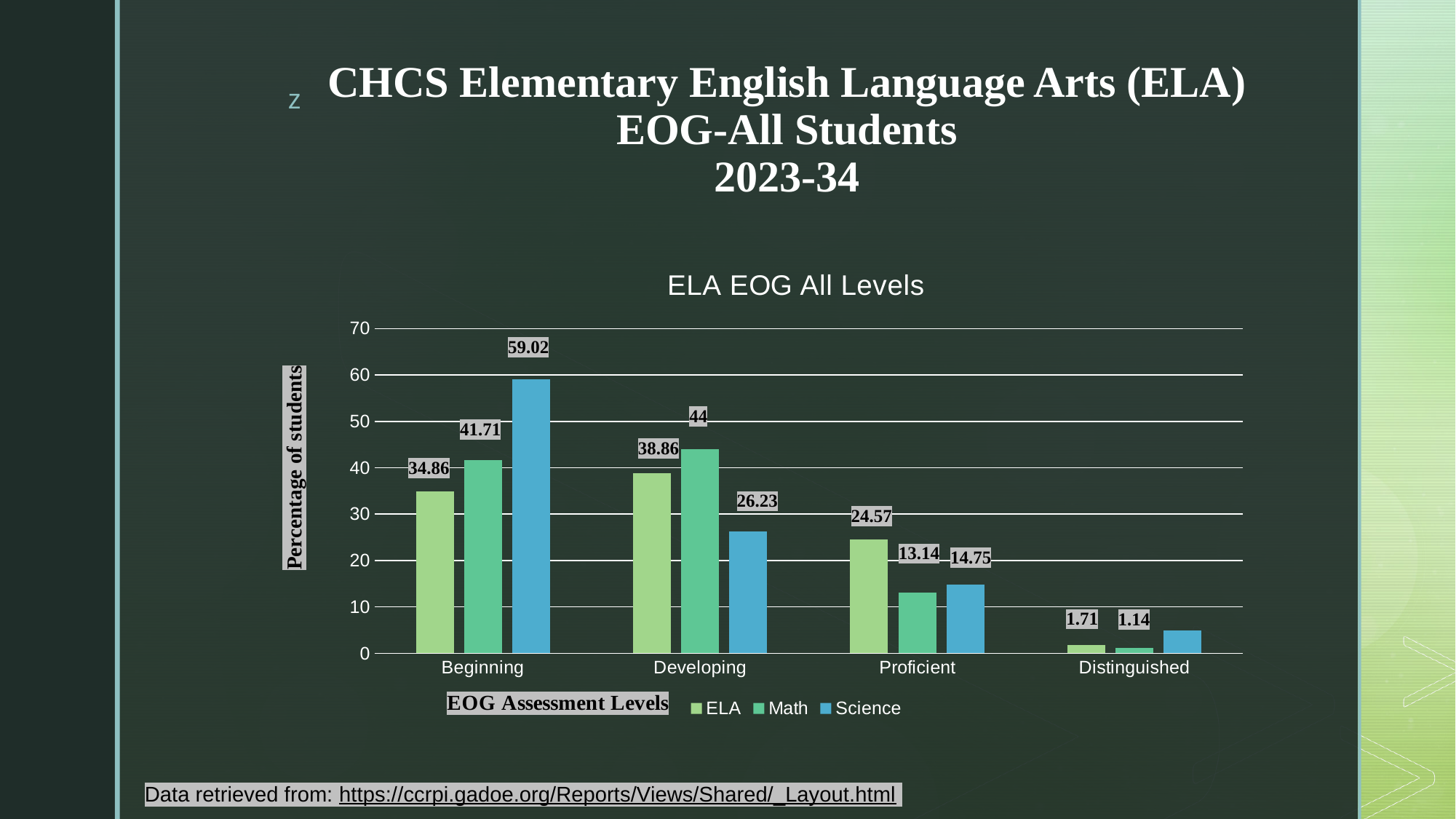
Which is larger for Proficient, the Science value or the Math value? Science What is the Science value for Beginning? 59.02 What is the title of the chart? ELA EOG All Levels What is the ELA value for Developing? 38.86 What is the Math value for Proficient? 13.14 What is the difference between the Math and ELA values for Beginning? 6.85 Which assessment level has the lowest ELA value? Distinguished How many series does the legend list? 3 How many assessment levels are shown on the x axis? 4 Is the Science value for Distinguished greater or less than 10? less Which assessment level has the highest Science value? Beginning What kind of chart is shown? bar chart